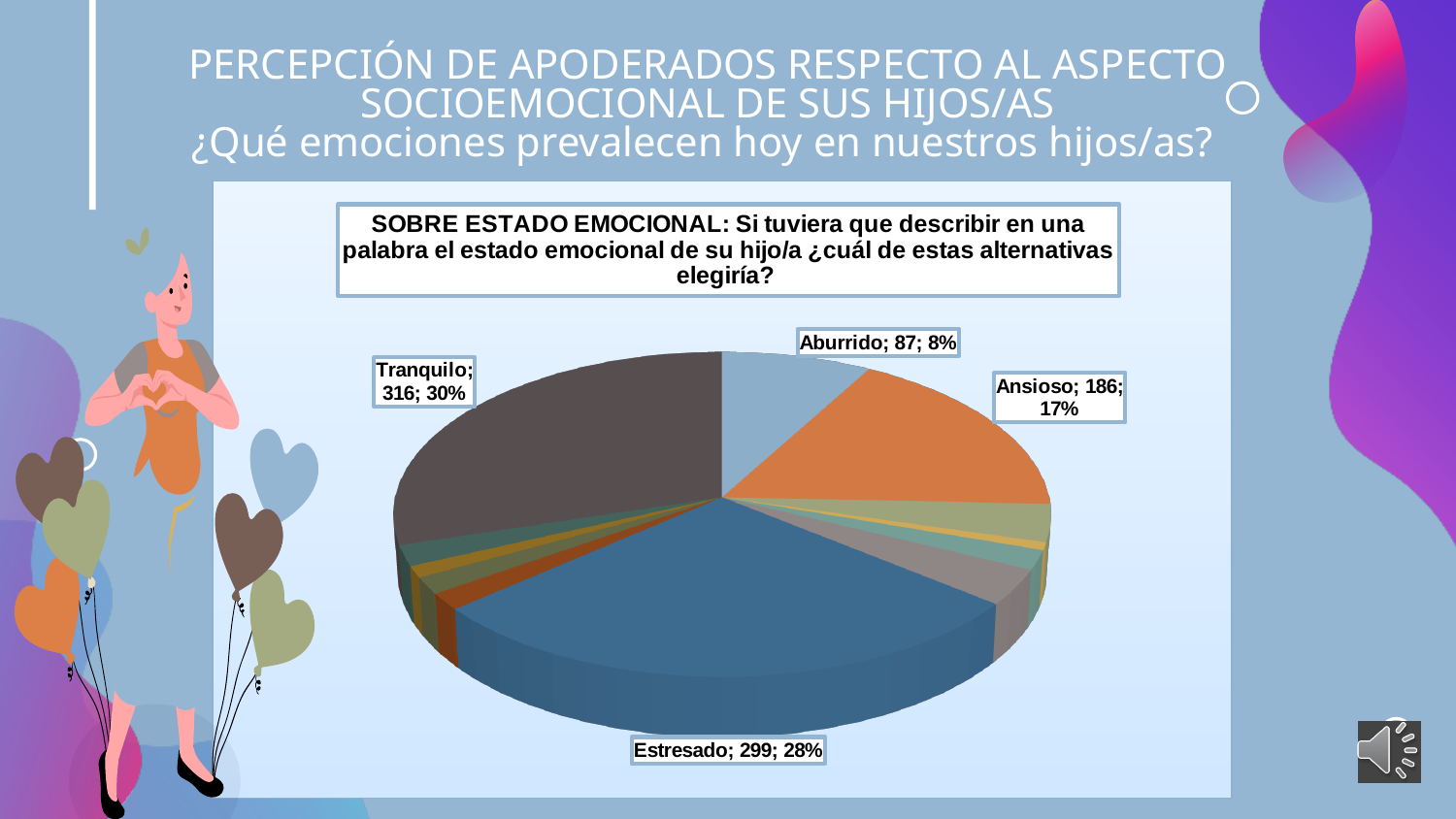
What type of chart is shown on the slide? Pie chart What is the first word of the chart's title box? SOBRE Which has a larger value, "Aburrido" or "Ansioso"? Ansioso What percentage of the pie chart corresponds to "Ansioso"? 17% What is the difference between the counts for "Ansioso" and "Aburrido"? 99 What percentage does the "Aburrido" slice represent? 8% Which emotion has the largest slice in the pie chart? Tranquilo Which has a larger value, "Estresado" or "Ansioso"? Estresado What is the difference between the counts for "Tranquilo" and "Estresado"? 17 What is the count shown for "Estresado" in the pie chart? 299 What share of the pie does "Estresado" account for? 28% How many respondents chose "Tranquilo" in the pie chart? 316